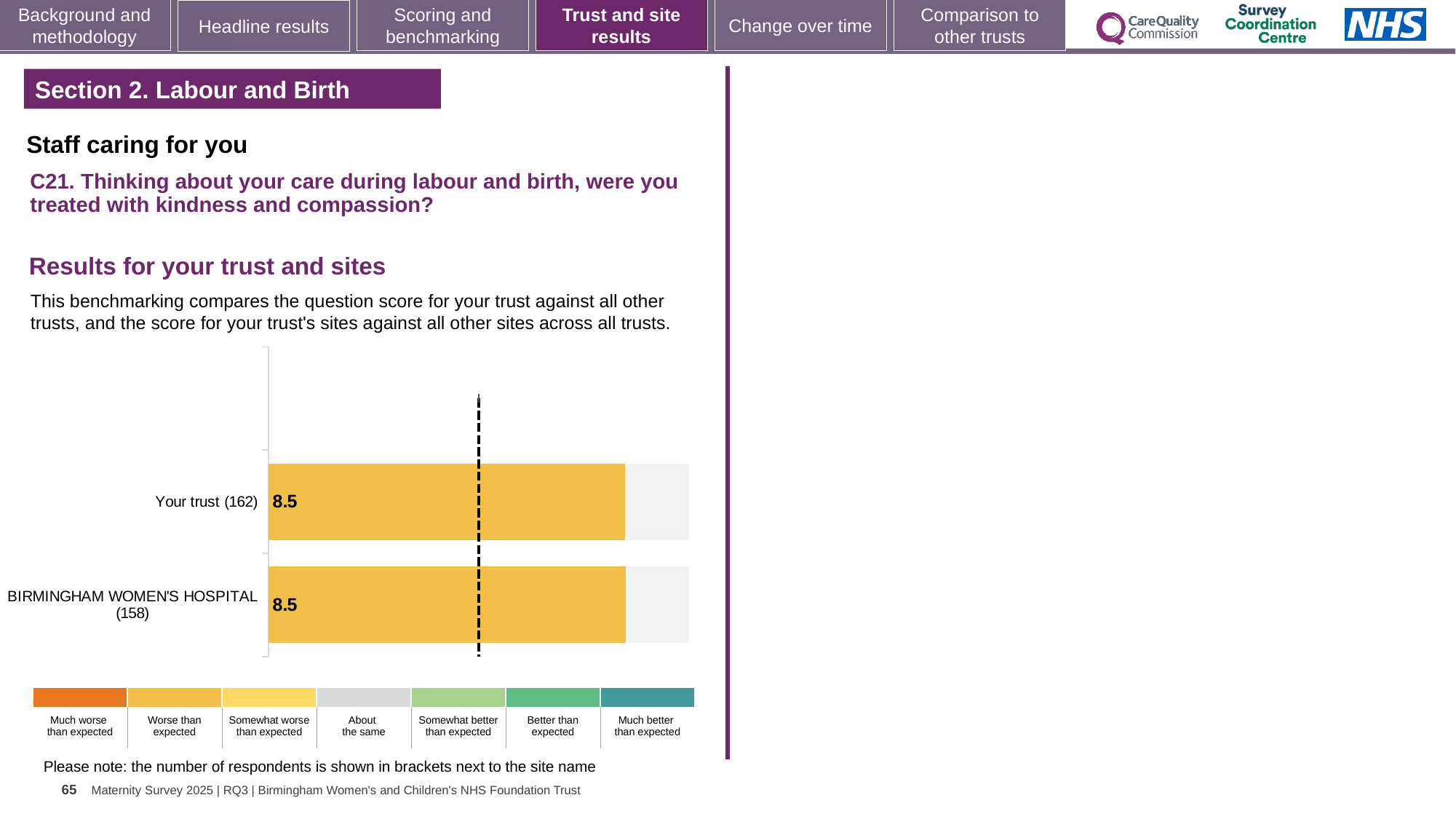
What is the score for Your trust (162)? 8.5 What is the difference between the score for Your trust (162) and the score for BIRMINGHAM WOMEN'S HOSPITAL (158)? 0.0 Which survey question does the chart report results for? C21. Thinking about your care during labour and birth, were you treated with kindness and compassion? How many respondents are shown in brackets for Your trust? 162 Which benchmark category does the colour of the bar for Your trust (162) correspond to in the key? Worse than expected How many respondents are shown in brackets for BIRMINGHAM WOMEN'S HOSPITAL? 158 How many benchmark categories does the colour key below the chart list? 7 What is the score for BIRMINGHAM WOMEN'S HOSPITAL (158)? 8.5 What kind of chart is shown on the slide? Bar chart How many bars are plotted in the chart? 2